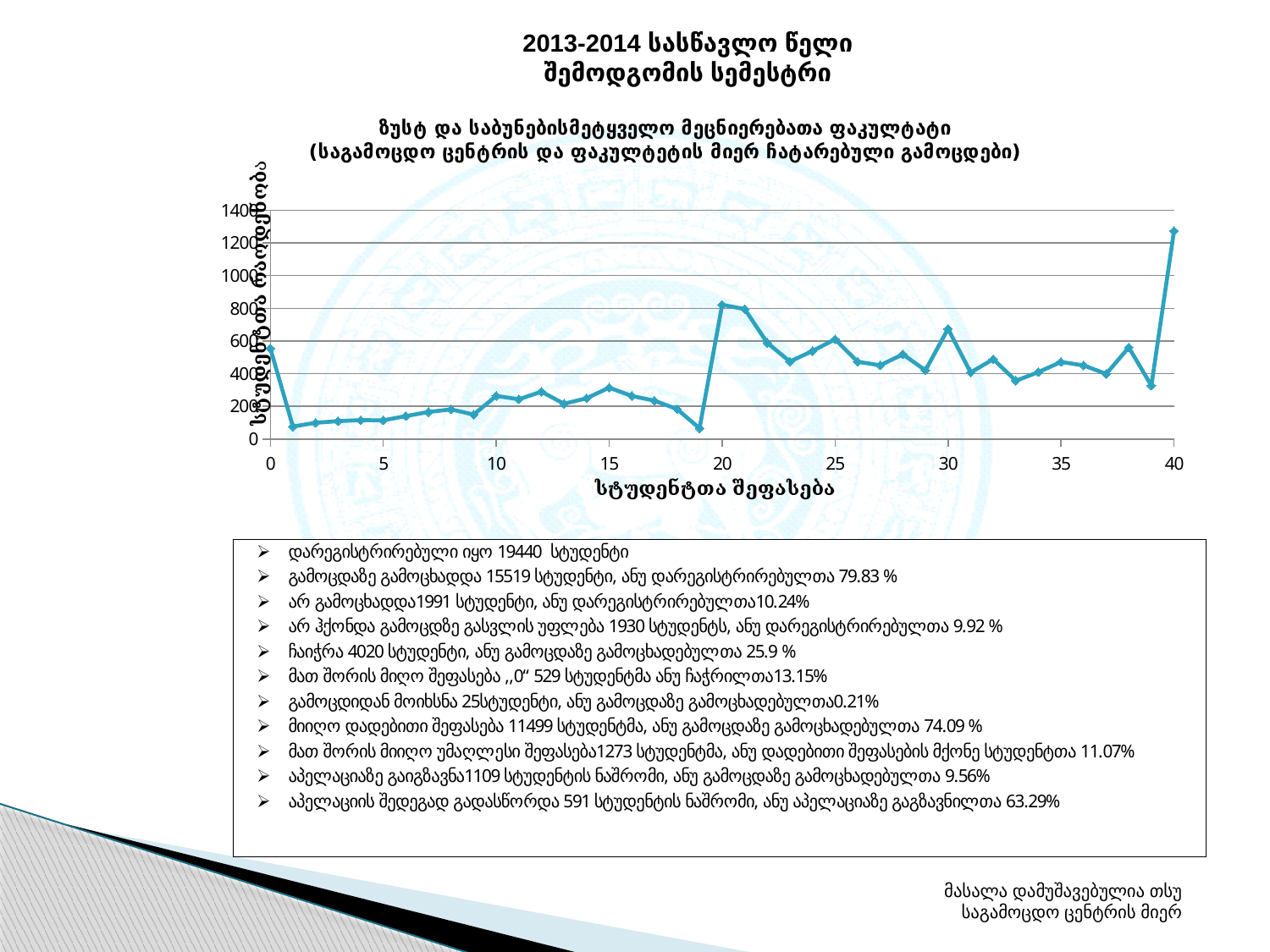
What kind of chart is shown on the slide? line chart At which x-axis value (student grade) does the line reach its highest point? 40 Is the value at x = 40 greater or less than 1200? greater Do the values generally rise or fall along the x axis between x = 1 and x = 15? rise Which is larger, the value at x = 20 or the value at x = 30? x = 20 What is the label of the y axis? სტუდენტთა რაოდენობა What is the label of the x axis? სტუდენტთა შეფასება Is the value at x = 30 greater or less than 600? greater Is the value at x = 5 greater or less than 200? less